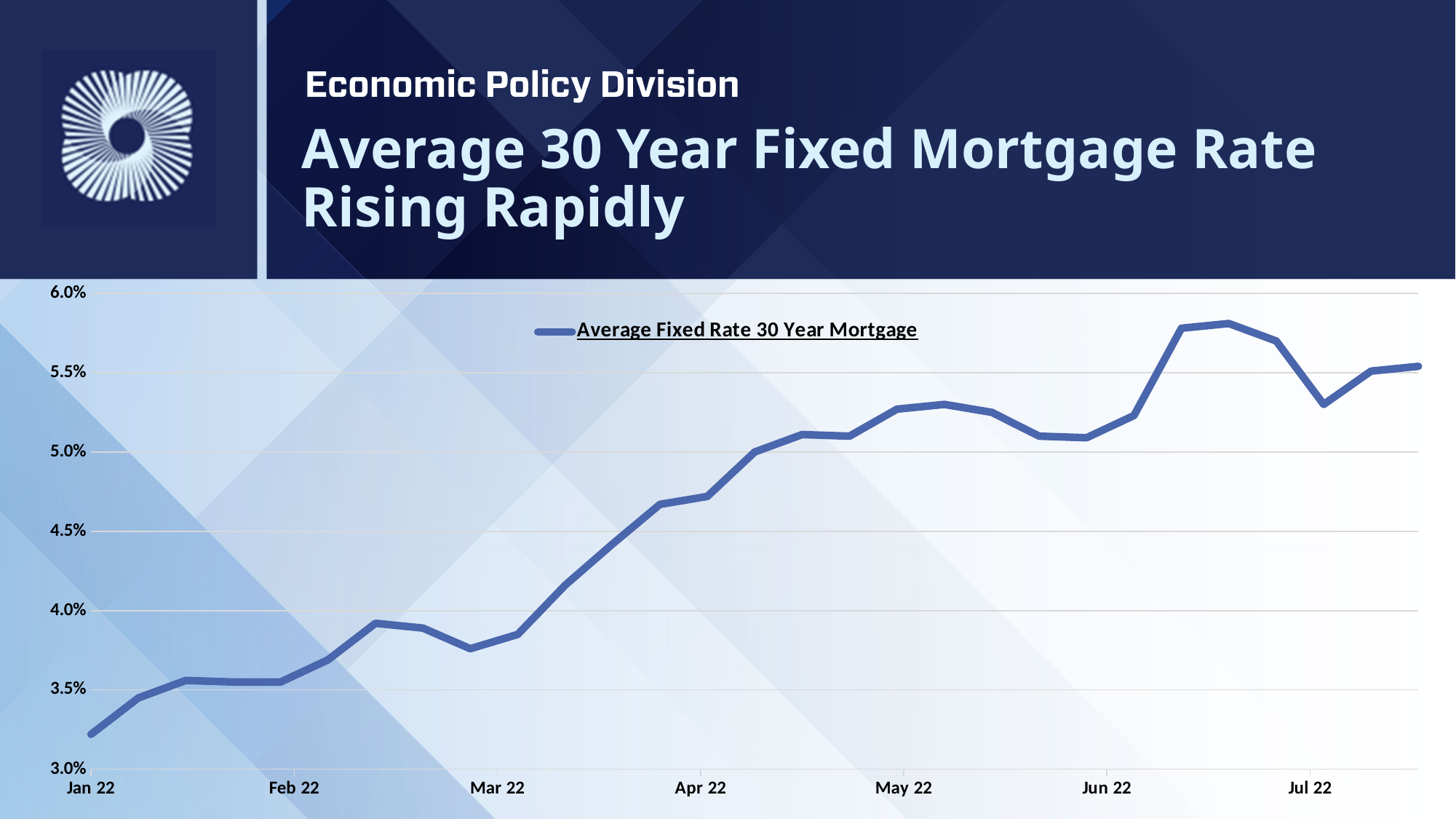
What kind of chart is shown on the slide? line chart How many series does the legend list? 1 Is the value at Apr 22 greater or less than 4.5%? greater Overall, do the values rise or fall from Jan 22 to Jul 22? rise How many month labels are shown on the x axis? 7 Is the value at Jan 22 greater or less than 3.5%? less Which is larger, the value at Jul 22 or the value at Jan 22? Jul 22 What is the name of the series shown in the legend? Average Fixed Rate 30 Year Mortgage Is the highest point on the line greater or less than 6.0%? less What is the title of the slide containing the chart? Average 30 Year Fixed Mortgage Rate Rising Rapidly